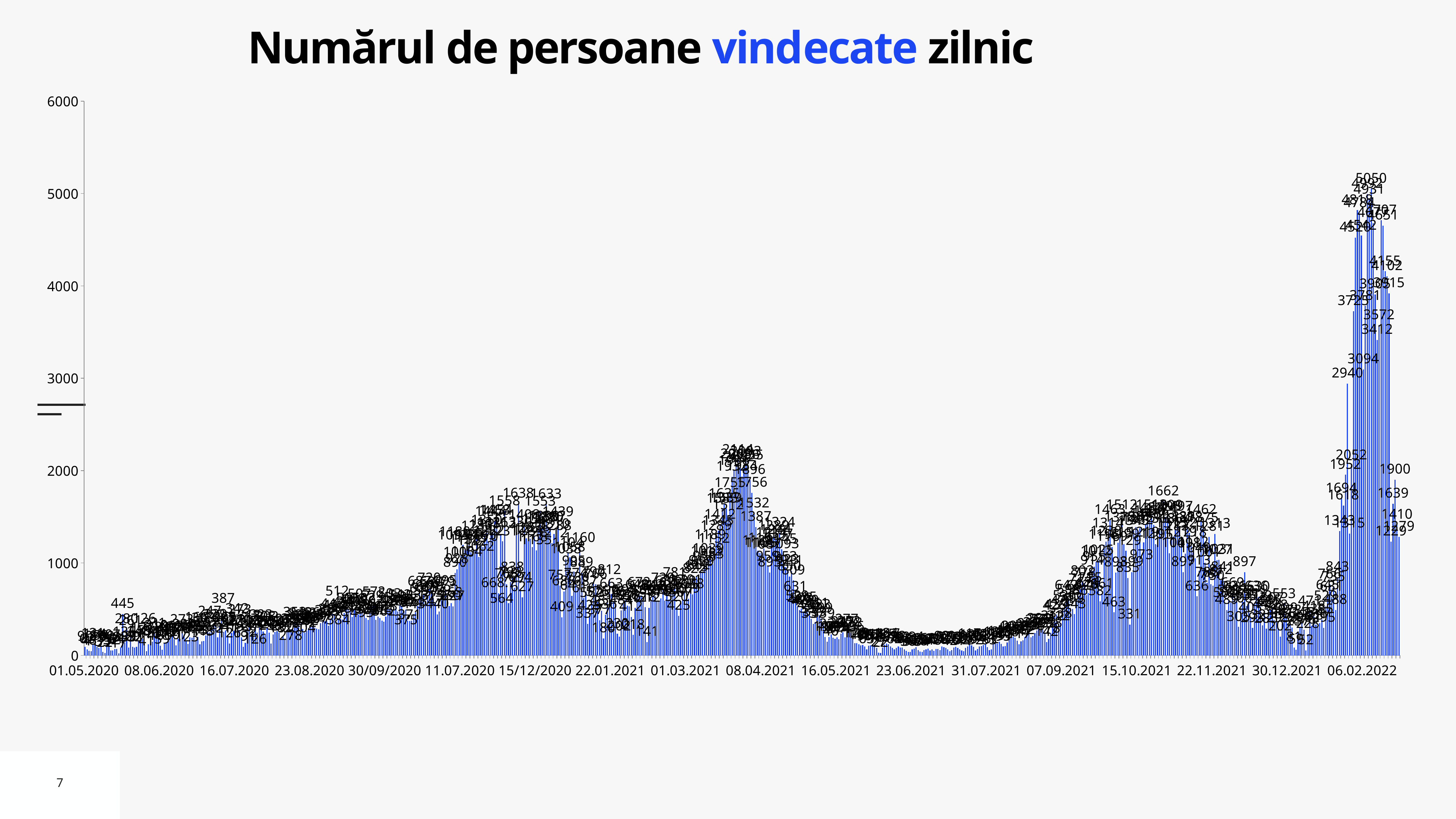
Is the highest value on the chart greater or less than 5000? greater Are the values around 23.06.2021 greater or less than 500? less Do the values rise or fall between 08.04.2021 and 23.06.2021? fall What colour are the bars in the chart? blue Is the value for the first bar, at 01.05.2020, greater or less than 1000? less What kind of chart is shown on the slide? bar chart Do the values rise or fall between 23.06.2021 and 15.10.2021? rise What is the title of the chart? Numărul de persoane vindecate zilnic Which peak is higher: the one around 08.04.2021 or the one around 06.02.2022? 06.02.2022 What is the highest data label shown on the chart? 5050